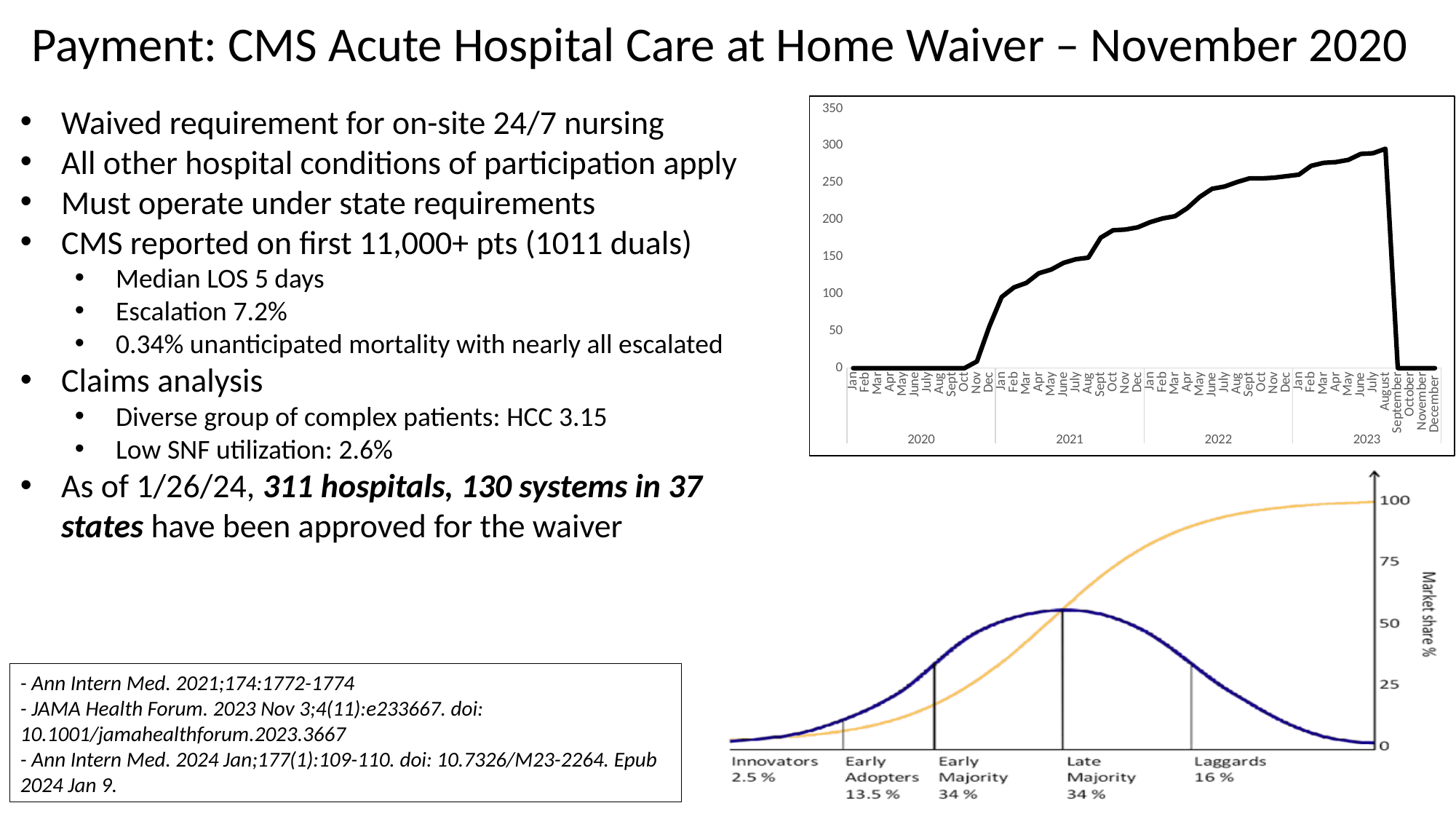
In the top-right line chart, is the value for Nov 2020 greater or less than 50? less In the top-right line chart, how many years are labeled along the x axis? 4 In the bottom-right adoption curve chart, what is the difference between the Laggards percentage and the Early Adopters percentage? 2.5 % In the bottom-right adoption curve chart, how many adopter groups are labeled along the bottom? 5 In the bottom-right adoption curve chart, which adopter group has the smallest percentage? Innovators In the bottom-right adoption curve chart, what percentage is shown for Innovators? 2.5 % In the top-right line chart, is the value for August 2023 greater or less than 250? greater In the bottom-right adoption curve chart, what percentage is shown for Early Adopters? 13.5 % In the top-right line chart, is the value for Jan 2022 greater or less than 150? greater What kind of chart is the top-right chart on the slide? line chart In the top-right line chart, does the line generally rise or fall from Jan 2021 to July 2023? rise